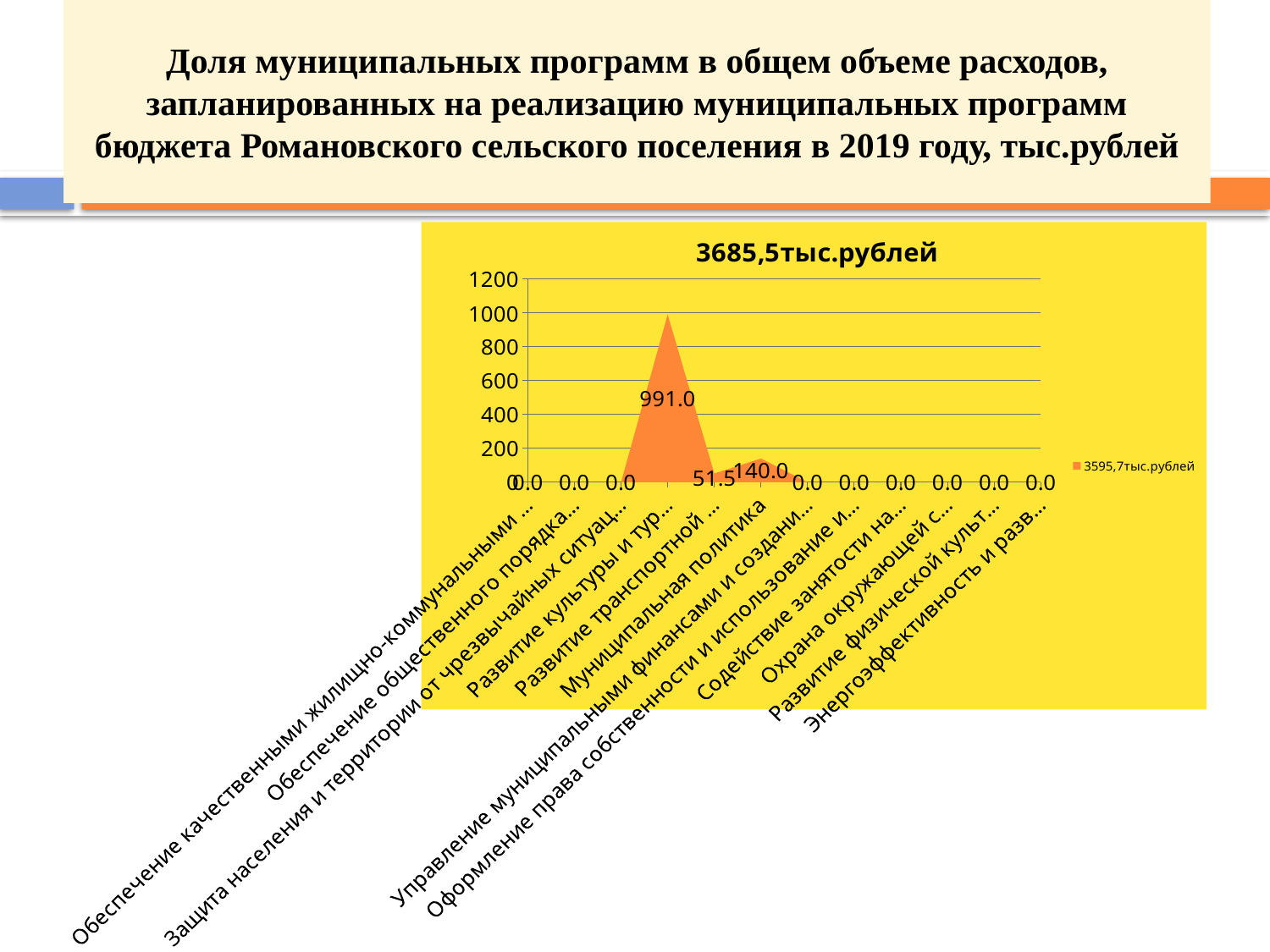
Which category has the highest value? Развитие культуры и тур... What is the legend entry of the chart? 3595,7тыс.рублей What is the maximum value shown on the y axis? 1200 How many categories are shown on the x axis? 12 What is the title of the chart? 3685,5тыс.рублей What is the value for the category Развитие транспортной...? 51.5 How many series does the legend list? 1 What is the difference between the value for Муниципальная политика and the value for Развитие транспортной...? 88.5 What is the highest value plotted on the chart? 991.0 What kind of chart is shown on the slide? area chart Which is larger: the value for Муниципальная политика or the value for Развитие транспортной...? Муниципальная политика What is the value for Муниципальная политика? 140.0